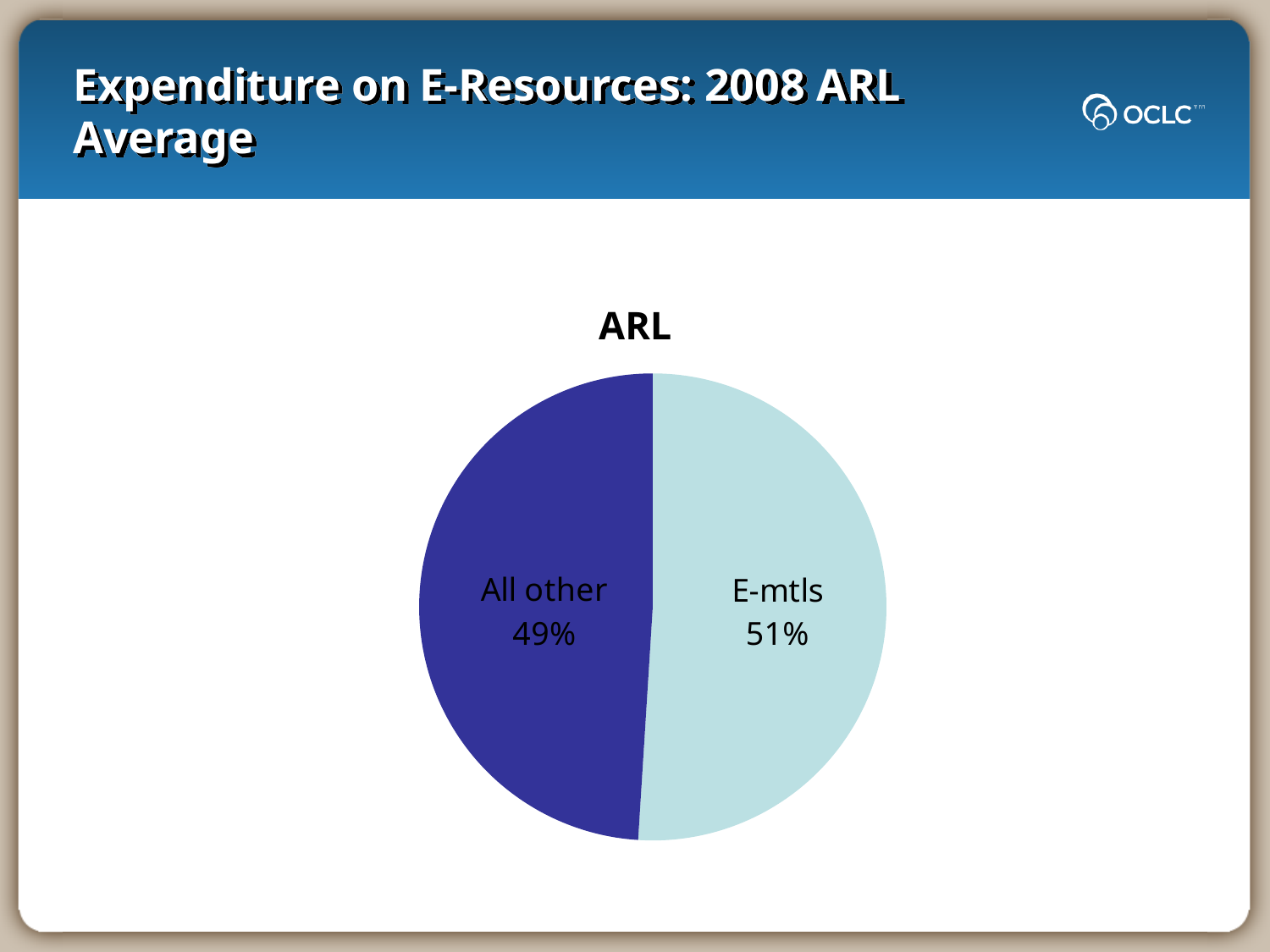
What share of the pie does All other represent? 49% What is the difference in percentage points between the E-mtls slice and the All other slice? 2 percentage points What share of the pie does E-mtls represent? 51% Which slice of the pie is the largest? E-mtls What colour is the E-mtls slice? Light blue Which slice of the pie is the smallest? All other What kind of chart is shown on the slide? Pie chart What is the title of the chart? ARL How many slices does the pie chart have? 2 Which is larger, the E-mtls slice or the All other slice? E-mtls